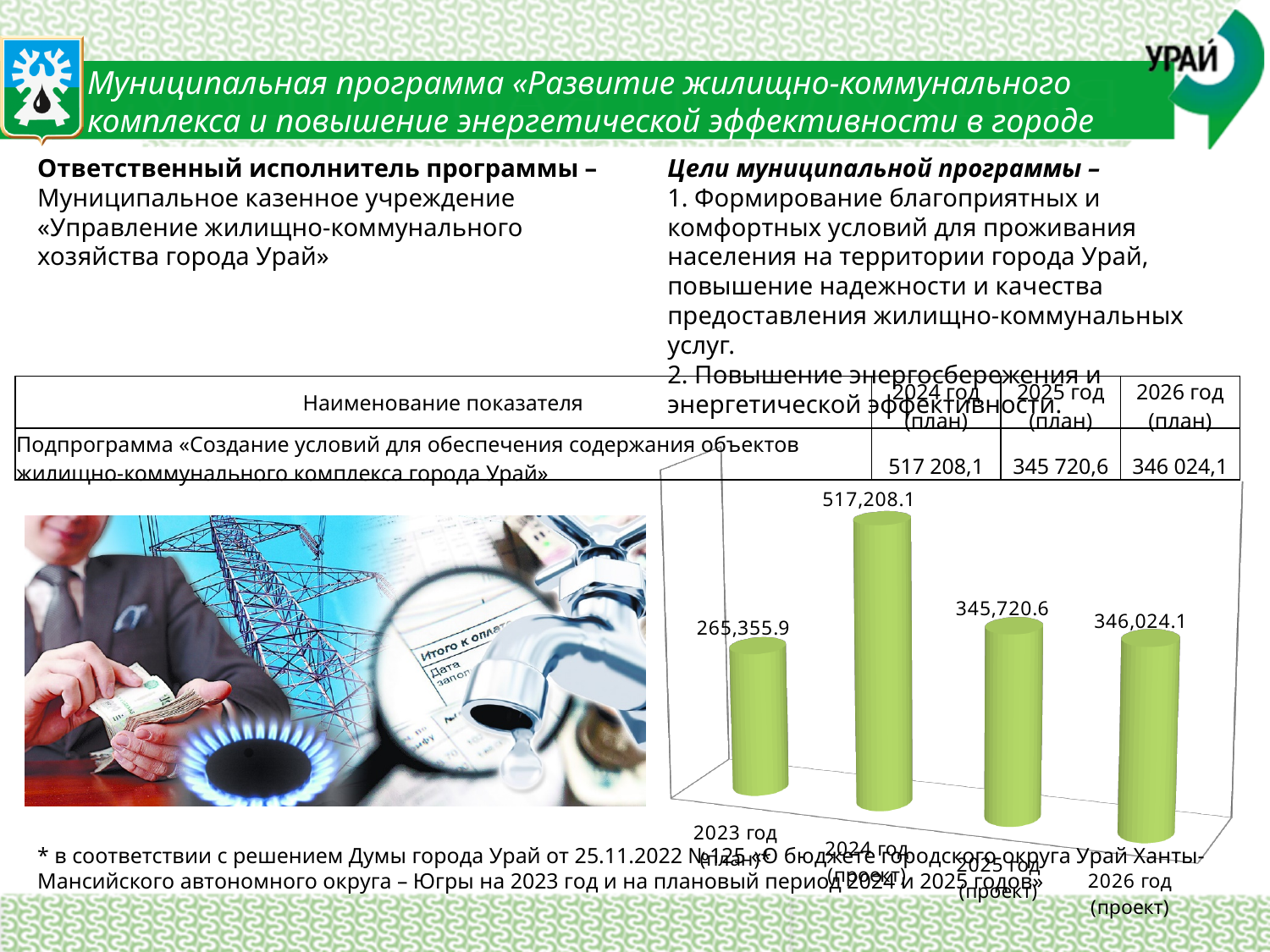
Which year has the lowest value in the chart? 2023 год (план) Which is larger, the value for 2024 год (проект) or the value for 2026 год (проект)? 2024 год (проект) What is the difference between the values for 2024 год (проект) and 2025 год (проект)? 171,487.5 What is the value shown for 2024 год (проект) in the chart? 517,208.1 What is the difference between the values for 2024 год (проект) and 2023 год (план)? 251,852.2 Does the value rise or fall from 2023 год (план) to 2024 год (проект)? Rise What kind of chart is shown on the slide? Bar chart Which year has the highest value in the chart? 2024 год (проект) What is the value shown for 2026 год (проект) in the chart? 346,024.1 How many bars are plotted in the chart? 4 What is the value shown for 2025 год (проект) in the chart? 345,720.6 What is the value shown for 2023 год (план) in the chart? 265,355.9